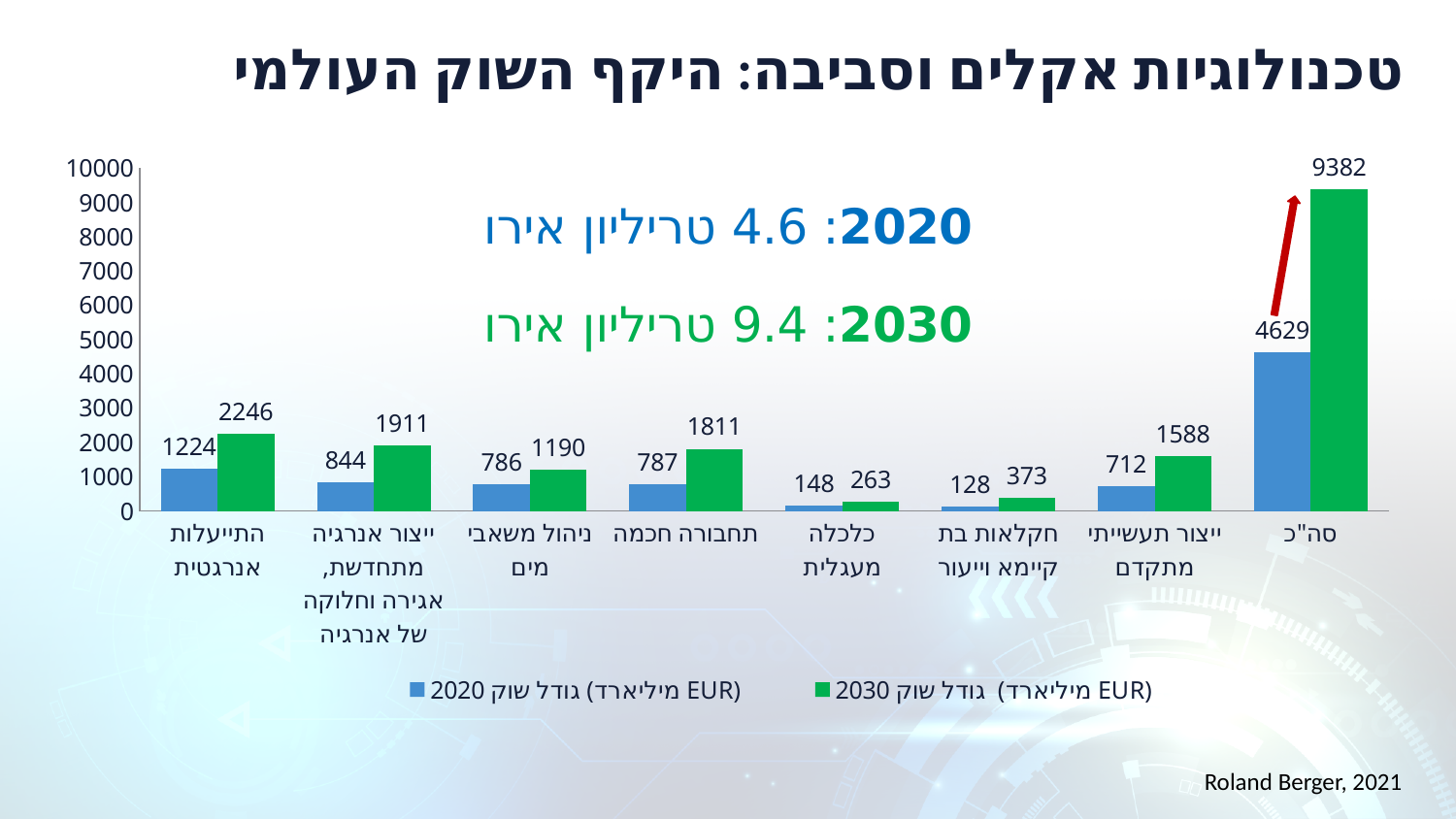
What is the 2030 market size value for התייעלות אנרגטית? 2246 What kind of chart is shown on the slide? bar chart What is the 2030 value shown for the סה"כ category? 9382 Excluding the סה"כ total, which category has the highest 2030 value? התייעלות אנרגטית What is the difference between the 2030 and 2020 values for ניהול משאבי מים? 404 How many series does the legend list? 2 How many categories are shown on the x axis of the chart? 8 Which is larger: the 2030 value for ייצור תעשייתי מתקדם or the 2030 value for תחבורה חכמה? תחבורה חכמה Excluding the סה"כ total, which category has the lowest 2020 value? חקלאות בת קיימא וייעור Is the 2020 value for סה"כ greater or less than 4000? greater What is the 2020 market size value for תחבורה חכמה? 787 What is the 2020 value for כלכלה מעגלית? 148